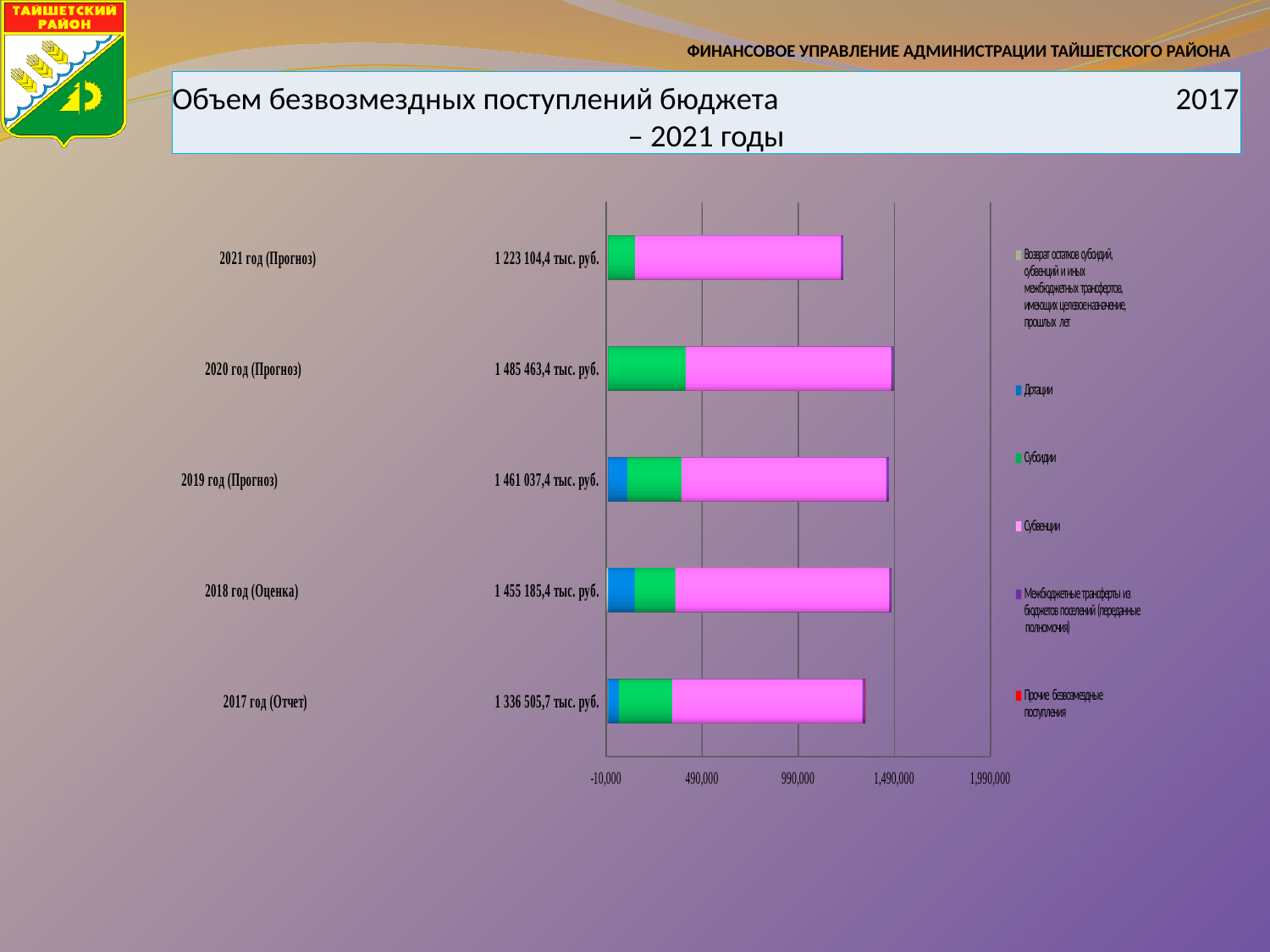
What is the total value shown for 2017 год (Отчет)? 1 336 505,7 тыс. руб. Is the total for 2021 год (Прогноз) greater or less than 1,490,000? less How many years (categories) are shown in the chart? 5 Which year has the lowest total value? 2021 год (Прогноз) What is the title of the slide's chart? Объем безвозмездных поступлений бюджета 2017 – 2021 годы Which year has the highest total value? 2020 год (Прогноз) How many series does the legend list? 6 What is the total value shown for 2021 год (Прогноз)? 1 223 104,4 тыс. руб. Which is larger, the total for 2019 год (Прогноз) or for 2018 год (Оценка)? 2019 год (Прогноз) What is the difference between the totals for 2020 год (Прогноз) and 2021 год (Прогноз)? 262 359,0 тыс. руб. What kind of chart is shown on the slide? Stacked bar chart What is the total value shown for 2018 год (Оценка)? 1 455 185,4 тыс. руб.